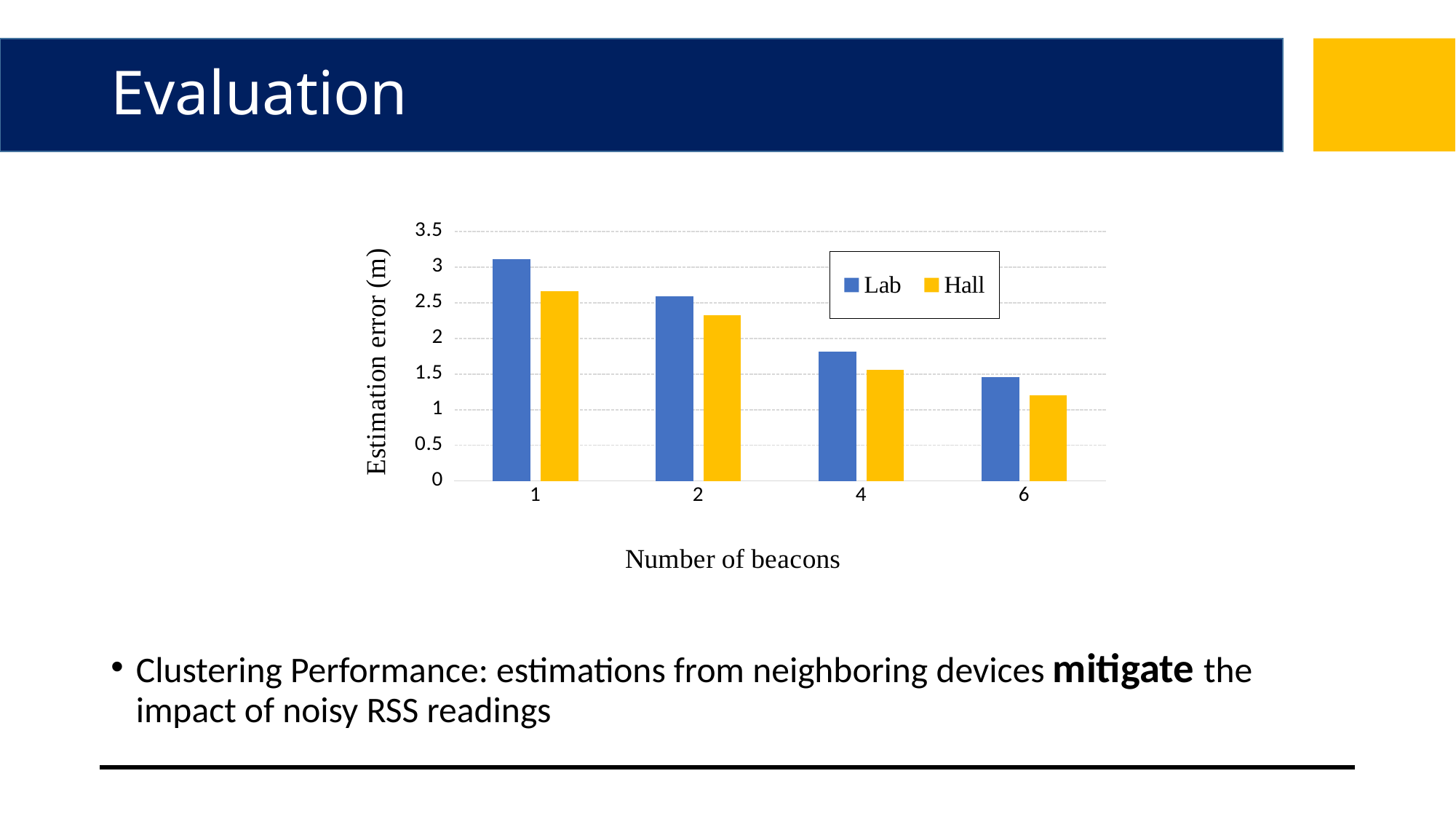
For which number of beacons is the Lab estimation error highest? 1 Is the Lab estimation error for 1 beacon greater or less than 3? greater Is the Lab estimation error for 4 beacons greater or less than 2? less Which series is shown in yellow in the legend? Hall What type of chart is shown on the slide? bar chart What is the label of the y axis? Estimation error (m) Which has a larger estimation error for 1 beacon, Lab or Hall? Lab How many series does the legend list? 2 Does the Lab estimation error rise or fall as the number of beacons increases? fall For which number of beacons is the Hall estimation error lowest? 6 Is the Hall estimation error for 2 beacons greater or less than 2.5? less How many categories are shown on the x axis (Number of beacons)? 4